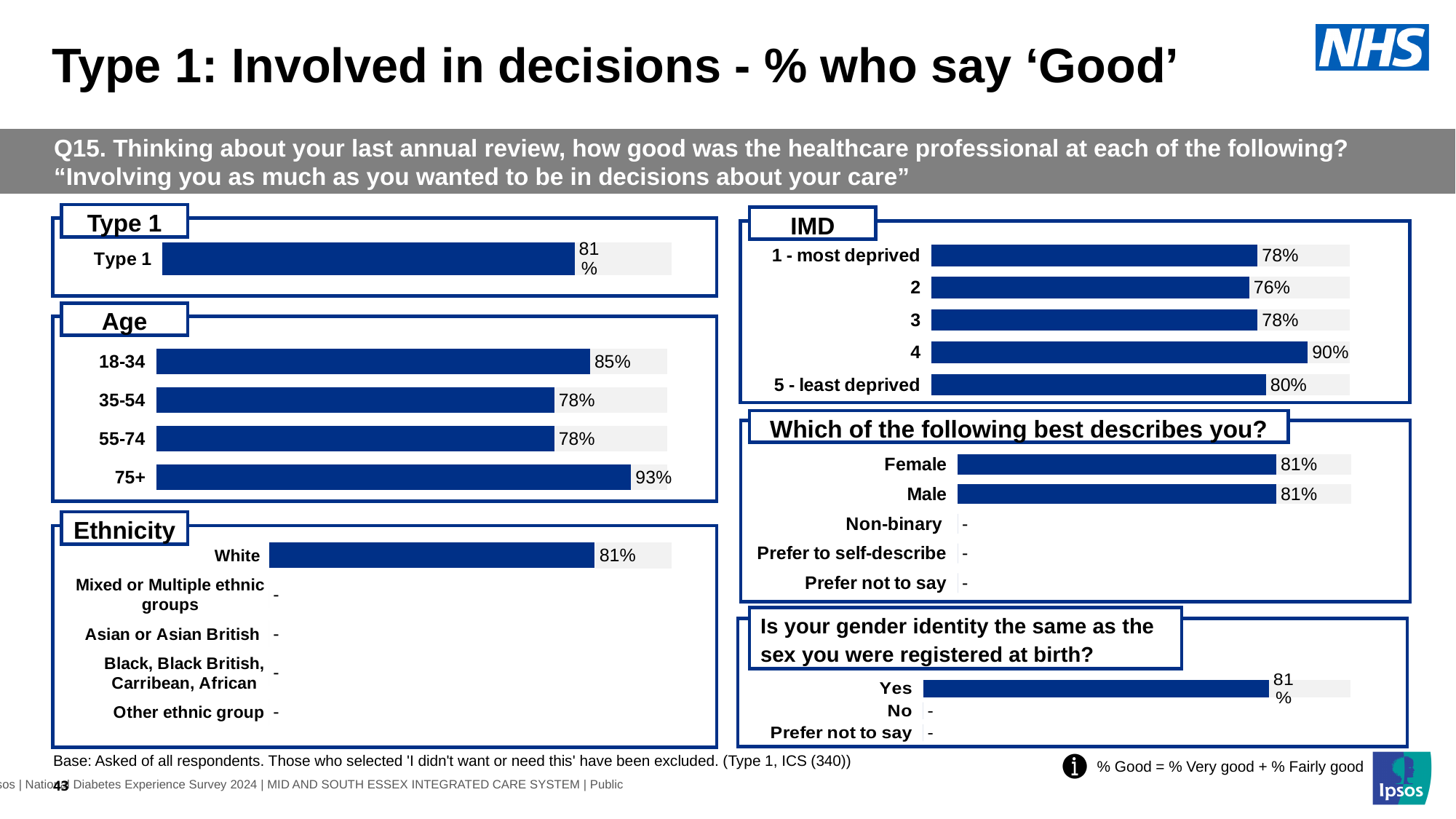
In the IMD chart, what is the value for 4? 90% In the IMD chart, which is larger: the value for 5 - least deprived or the value for 2? 5 - least deprived In the Age chart, what is the value for 18-34? 85% In the Age chart, what is the difference between the values for 75+ and 18-34? 8 percentage points In the 'Is your gender identity the same as the sex you were registered at birth?' chart, what is the value for Yes? 81% In the Age chart, which age group has the highest value? 75+ In the Ethnicity chart, what is the value for White? 81% In the IMD chart, how many categories are plotted? 5 In the 'Which of the following best describes you?' chart, what is the value for Male? 81% In the IMD chart, which category has the lowest value? 2 In the Type 1 chart, what is the value for Type 1? 81% What kind of chart is the Age chart? Bar chart